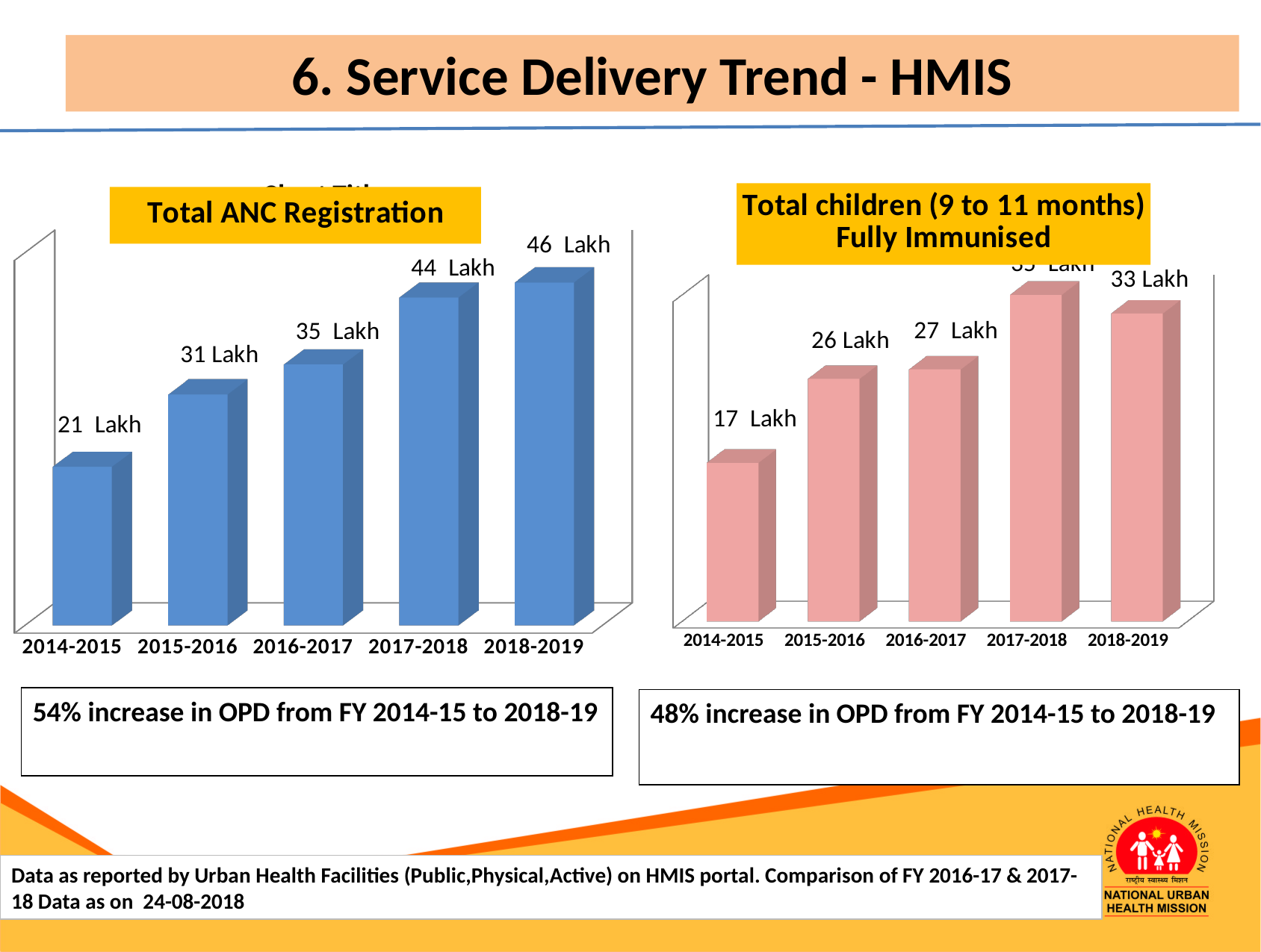
In the Total ANC Registration chart, which year has the highest value? 2018-2019 In the Total children (9 to 11 months) Fully Immunised chart, what is the value for 2015-2016? 26 Lakh In the Total ANC Registration chart, what is the difference between the values for 2018-2019 and 2014-2015? 25 Lakh In the Total children (9 to 11 months) Fully Immunised chart, which year has the highest value? 2017-2018 In the Total ANC Registration chart, what is the value for 2014-2015? 21 Lakh In the Total ANC Registration chart, do the values rise or fall from 2014-2015 to 2018-2019? rise In the Total children (9 to 11 months) Fully Immunised chart, what is the value for 2018-2019? 33 Lakh In the Total children (9 to 11 months) Fully Immunised chart, which is larger, the value for 2016-2017 or 2014-2015? 2016-2017 In the Total ANC Registration chart, what is the value for 2017-2018? 44 Lakh How many years are shown on the x axis of the Total ANC Registration chart? 5 In the Total ANC Registration chart, which year has the lowest value? 2014-2015 In the Total children (9 to 11 months) Fully Immunised chart, which year has the lowest value? 2014-2015